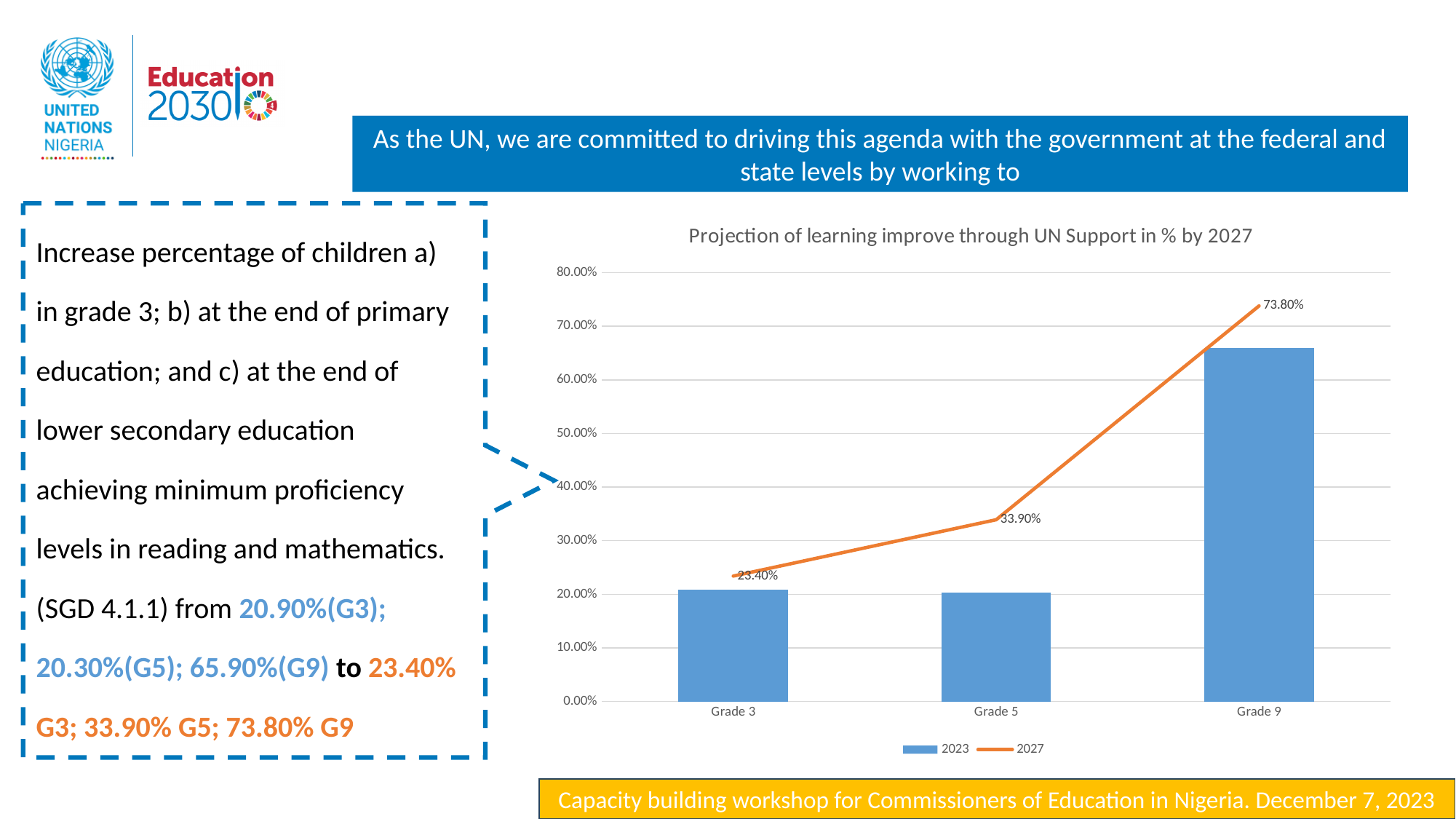
Does the 2027 line rise or fall from Grade 3 to Grade 9? rise Which grade has the lowest 2027 projected value? Grade 3 How many grade categories are shown on the x axis? 3 How many series does the legend list? 2 Which grade has the highest 2027 projected value? Grade 9 What is the 2027 projected value for Grade 5? 33.90% Is the 2023 bar for Grade 9 greater or less than 60.00%? greater Which has the larger 2023 value, Grade 3 or Grade 9? Grade 9 What is the 2027 projected value for Grade 3? 23.40% Is the 2023 bar for Grade 3 greater or less than 30.00%? less What is the 2027 projected value for Grade 9? 73.80% What is the difference between the 2027 values for Grade 9 and Grade 3? 50.40%